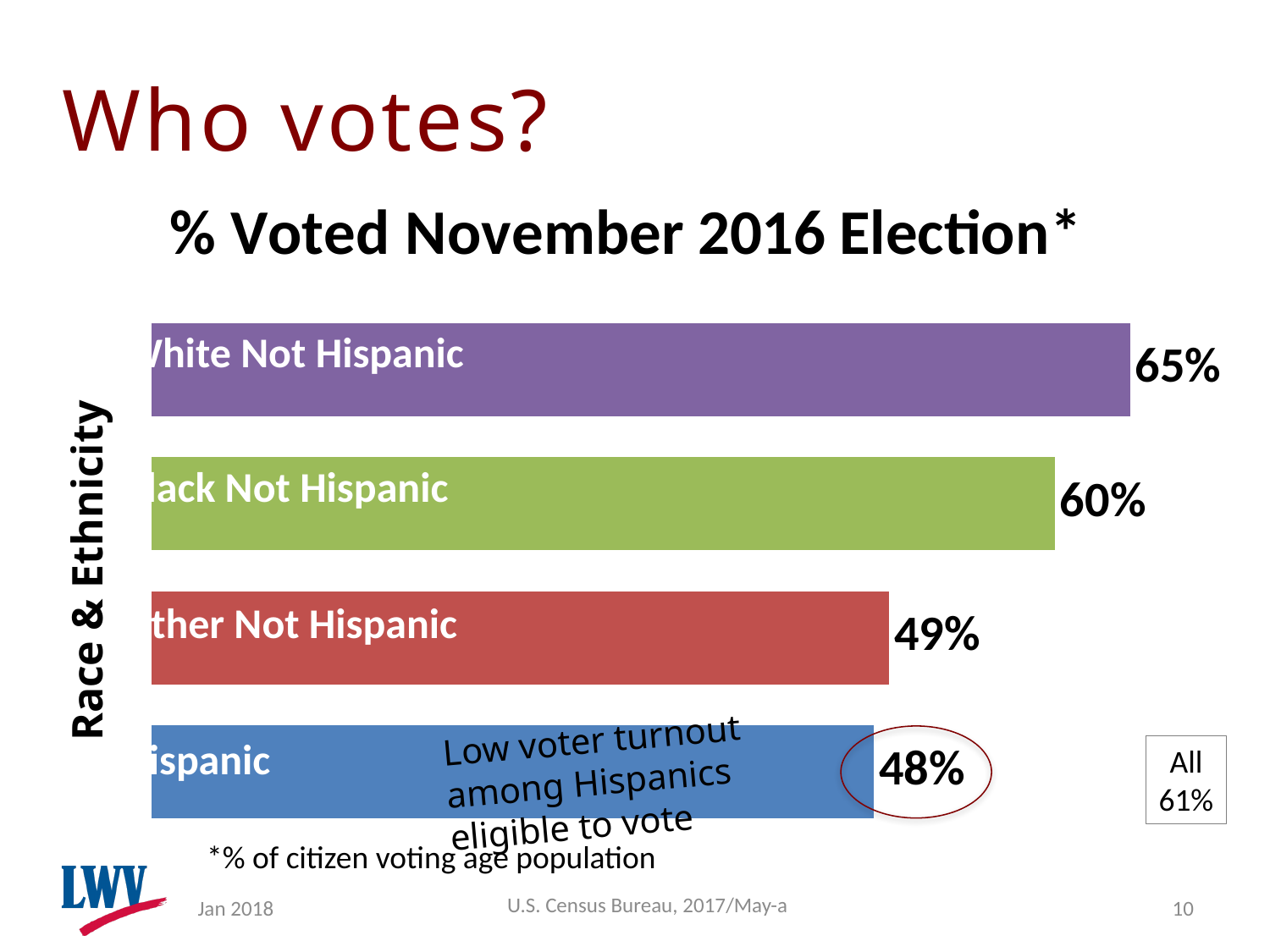
Which is larger, the value for Black Not Hispanic or the value for Other Not Hispanic? Black Not Hispanic What is the title of the chart? % Voted November 2016 Election* What is the value shown for Hispanic? 48% What percentage of White Not Hispanic citizens voted in the November 2016 election according to the chart? 65% What is the value shown for Other Not Hispanic? 49% Which race/ethnicity group has the highest voting percentage on the chart? White Not Hispanic What type of chart is shown on the slide? Bar chart How many race/ethnicity categories are plotted on the chart? 4 What is the difference in percentage points between Black Not Hispanic and Other Not Hispanic? 11 What is the difference in percentage points between White Not Hispanic and Hispanic? 17 What is the value shown for Black Not Hispanic? 60% Which race/ethnicity group has the lowest voting percentage on the chart? Hispanic